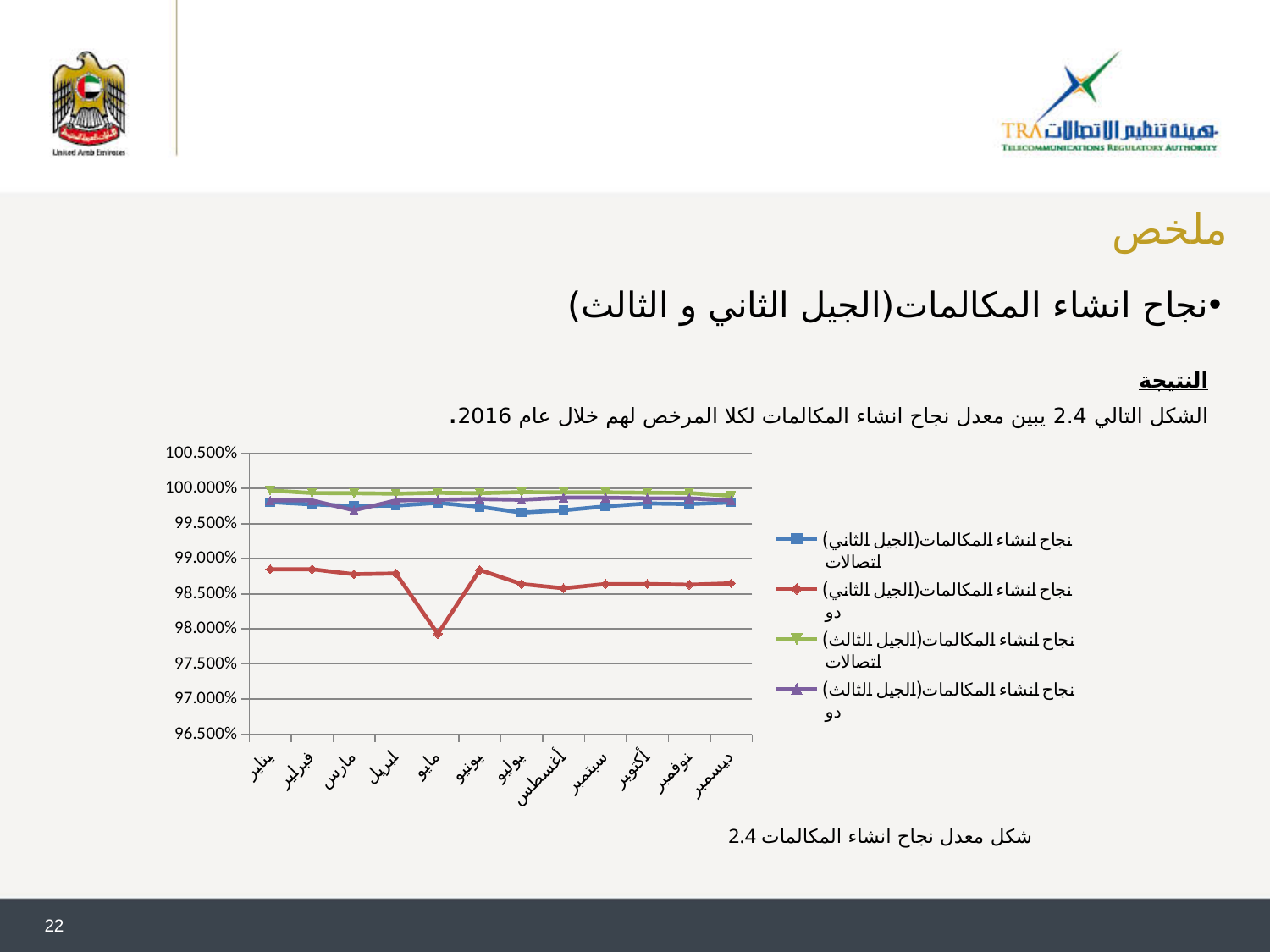
Is the value for نجاح انشاء المكالمات(الجيل الثالث) اتصالات in يناير greater or less than 99.500%? greater In which month does the series نجاح انشاء المكالمات(الجيل الثاني) دو reach its lowest value? مايو How many months are plotted along the x axis of the chart? 12 Is the value for نجاح انشاء المكالمات(الجيل الثاني) دو in أغسطس greater or less than 99.000%? less Is the value for نجاح انشاء المكالمات(الجيل الثاني) دو in يناير greater or less than 98.500%? greater What is the caption shown below the chart? شكل معدل نجاح انشاء المكالمات 2.4 In يناير, which series has the higher value: نجاح انشاء المكالمات(الجيل الثالث) اتصالات or نجاح انشاء المكالمات(الجيل الثاني) دو? نجاح انشاء المكالمات(الجيل الثالث) اتصالات What kind of chart is shown on the slide? line chart How many series does the chart's legend list? 4 What is the lowest value shown on the chart's y axis? 96.500% Which series is plotted in red on the chart? نجاح انشاء المكالمات(الجيل الثاني) دو